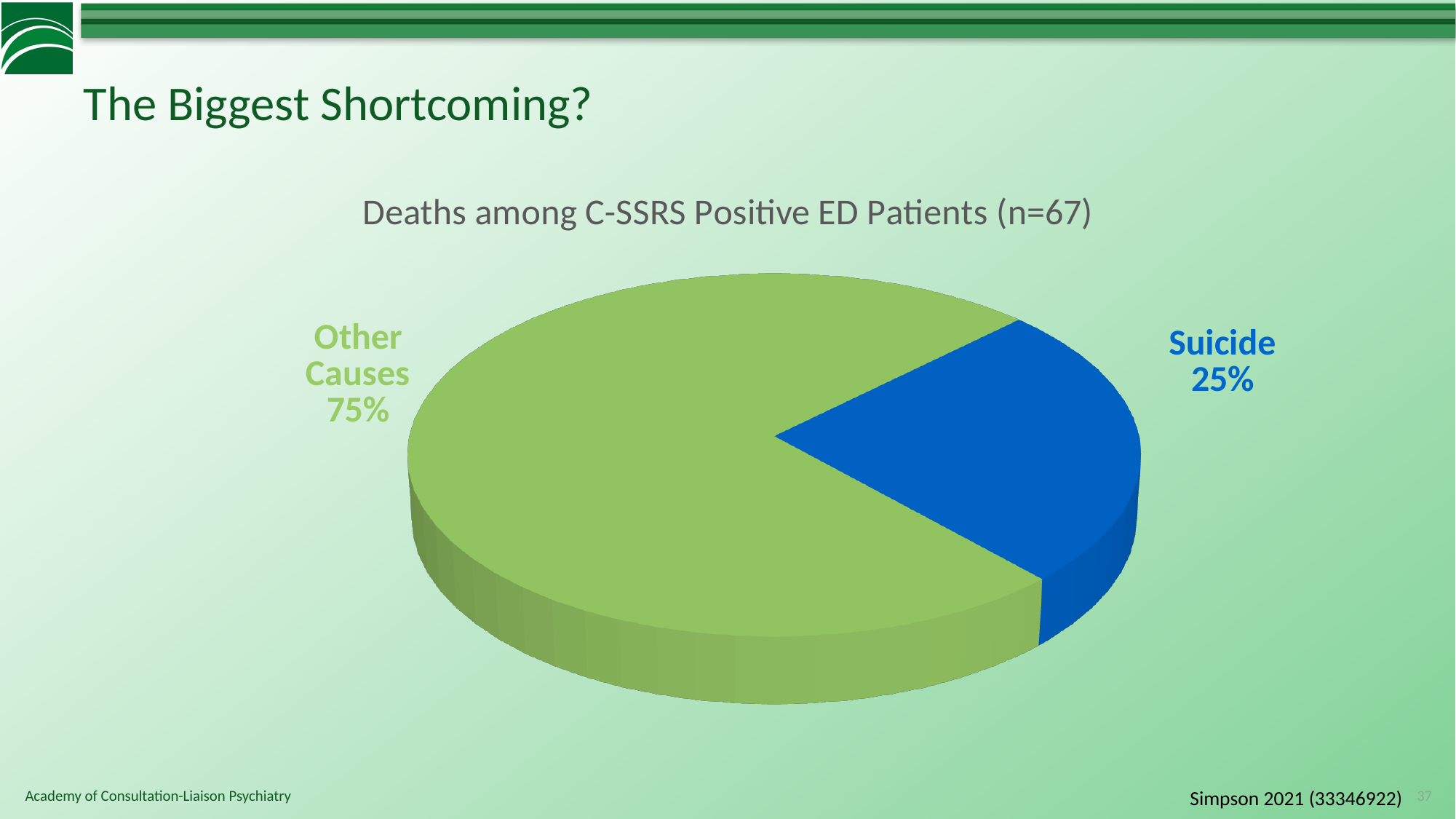
What kind of chart is shown on the slide? Pie chart What share of deaths is attributed to Suicide? 25% What is the sample size (n) stated in the chart title? 67 Which slice of the pie is the largest? Other Causes What is the difference in percentage points between Other Causes and Suicide? 50 What is the title of the chart? Deaths among C-SSRS Positive ED Patients (n=67) How many slices does the pie chart have? 2 What colour is the Suicide slice? Blue Which is larger, the Suicide slice or the Other Causes slice? Other Causes Which slice of the pie is the smallest? Suicide What share of deaths is attributed to Other Causes? 75%